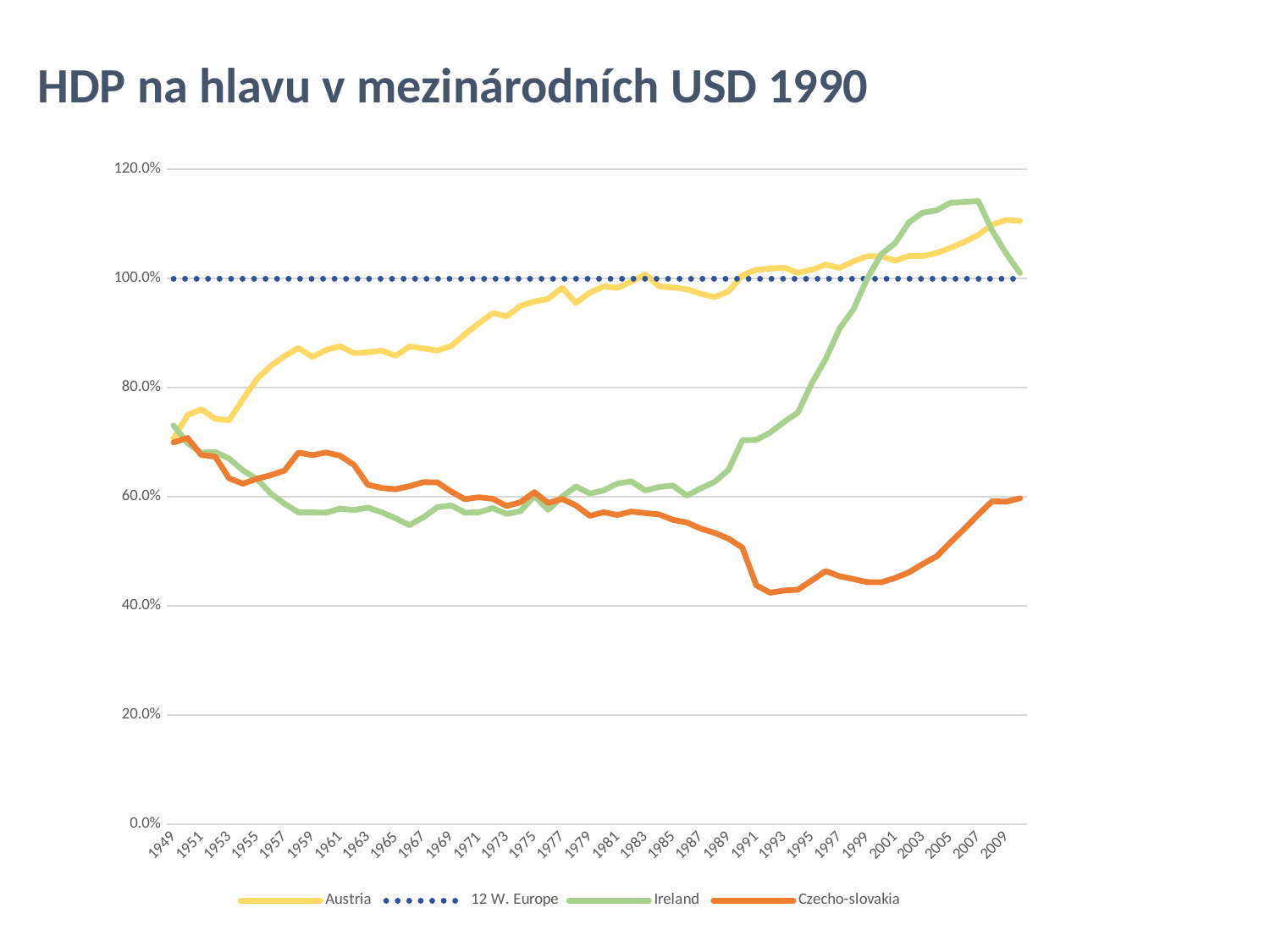
At what value does the 12 W. Europe line stay throughout the chart? 100.0% Which series has the highest value in 2007? Ireland What kind of chart is shown on the slide? line chart What is the title of the chart? HDP na hlavu v mezinárodních USD 1990 Which series has the lowest value in 2009? Czecho-slovakia Is the value for Austria in 1949 greater or less than 80%? less Is the value for Czecho-slovakia in 1993 greater or less than 60%? less Which series is drawn as a dotted line? 12 W. Europe Is the value for Ireland in 1967 greater or less than 60%? less In 2001, which is larger: the value for Ireland or the value for Czecho-slovakia? Ireland How many series does the legend list? 4